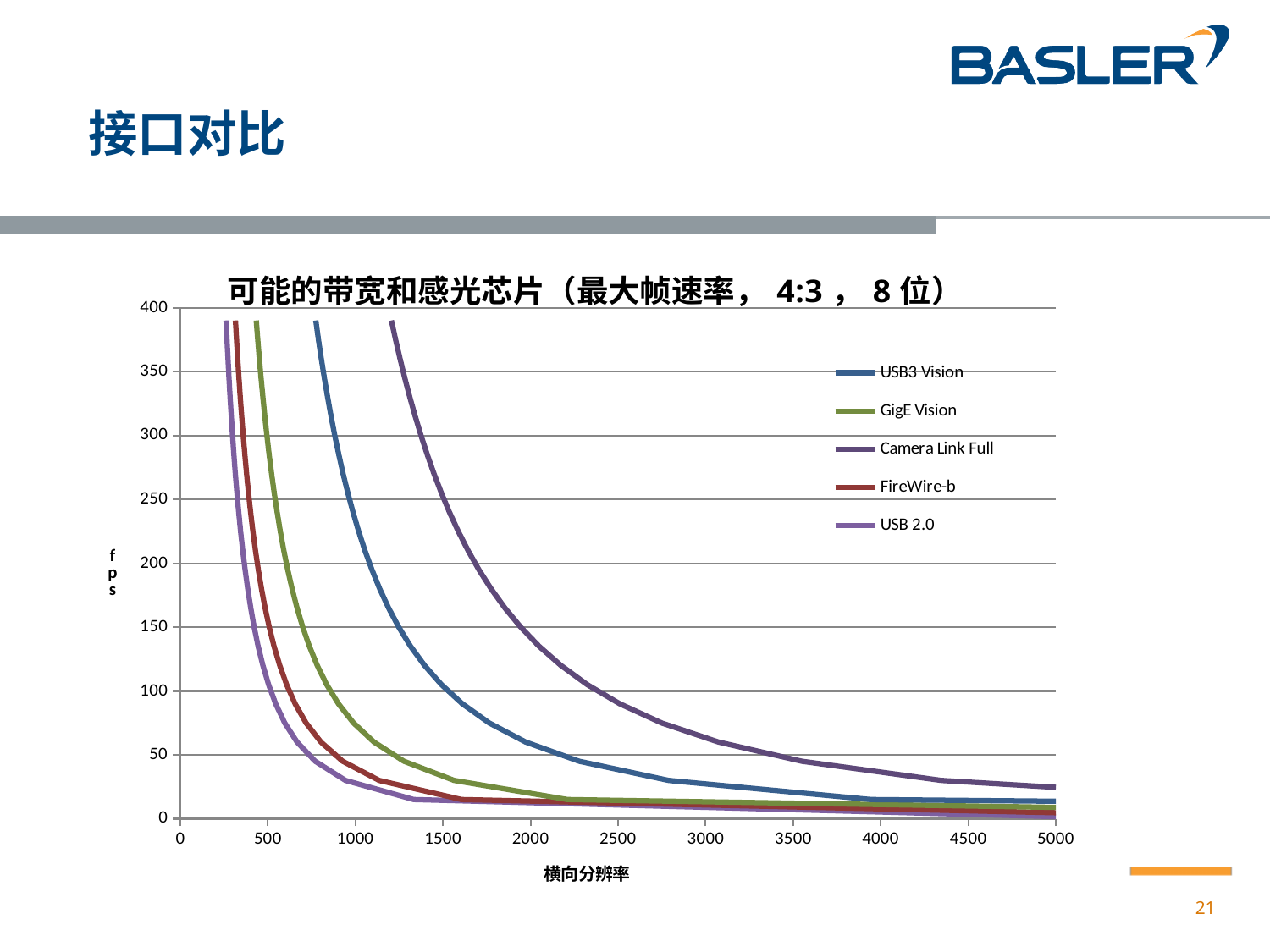
Is the fps value for Camera Link Full at a horizontal resolution of 3000 greater or less than 50? greater Is the fps value for GigE Vision at a horizontal resolution of 1500 greater or less than 50? less At a horizontal resolution of 3000, which is larger: the fps for Camera Link Full or for USB3 Vision? Camera Link Full At a horizontal resolution of 1000, which is larger: the fps for USB3 Vision or for GigE Vision? USB3 Vision How many series does the legend list? 5 What kind of chart is shown on the slide? line chart Do the values of the USB3 Vision series rise or fall as the horizontal resolution increases? fall Is the fps value for USB3 Vision at a horizontal resolution of 3000 greater or less than 50? less What is the label of the x axis? 横向分辨率 Which series has the highest fps at a horizontal resolution of 3000? Camera Link Full Which series has the lowest fps at a horizontal resolution of 1000? USB 2.0